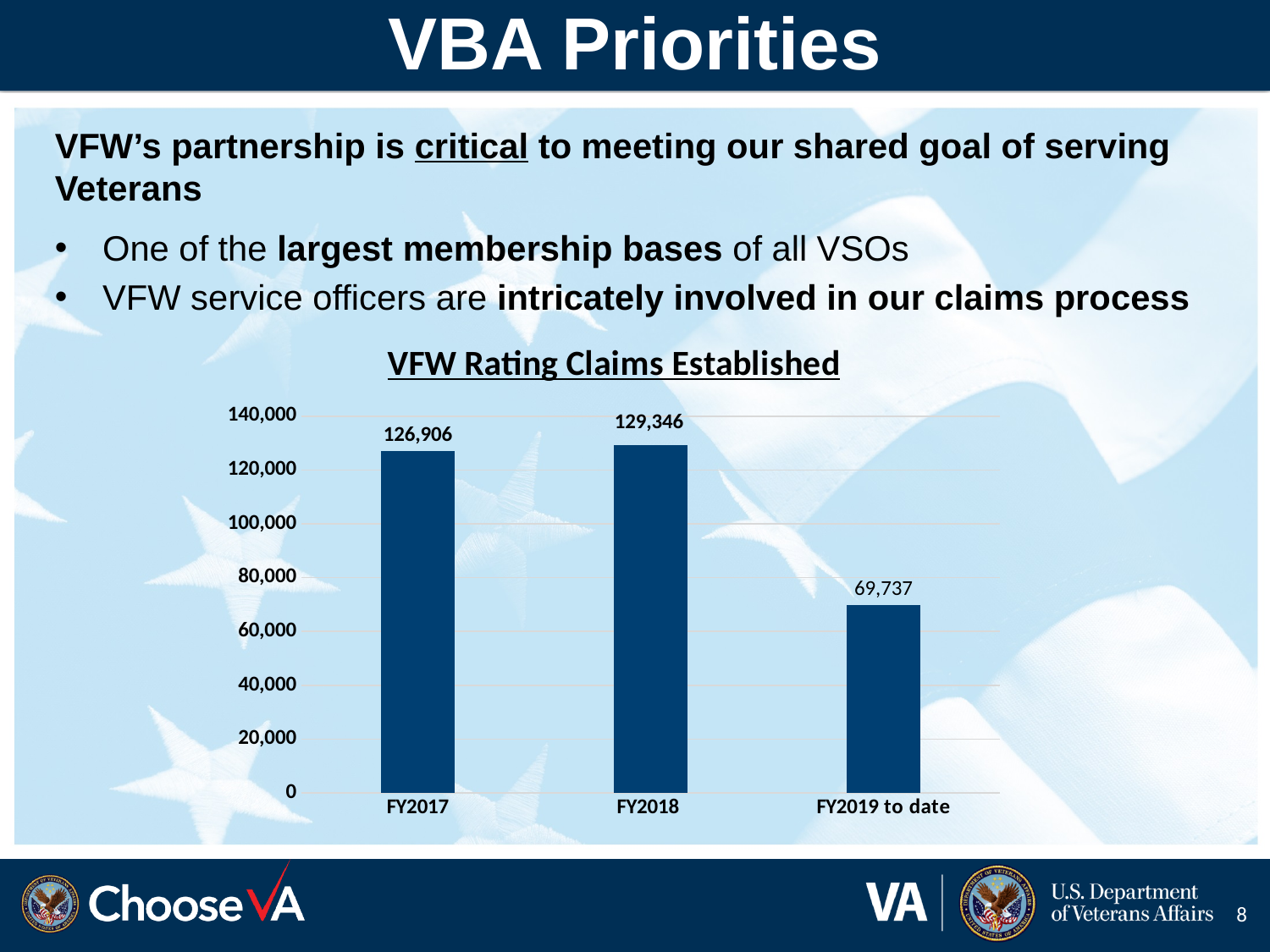
Which is larger in the VFW Rating Claims Established chart, the value for FY2017 or the value for FY2019 to date? FY2017 Which category has the lowest value in the VFW Rating Claims Established chart? FY2019 to date What is the difference between the FY2018 and FY2019 to date values in the VFW Rating Claims Established chart? 59,609 What kind of chart is the VFW Rating Claims Established chart? bar chart What is the value for FY2018 in the VFW Rating Claims Established chart? 129,346 Which category has the highest value in the VFW Rating Claims Established chart? FY2018 What is the title of the chart on the slide? VFW Rating Claims Established How many categories are shown in the VFW Rating Claims Established chart? 3 What is the value for FY2017 in the VFW Rating Claims Established chart? 126,906 What is the difference between the FY2018 and FY2017 values in the VFW Rating Claims Established chart? 2,440 What is the value for FY2019 to date in the VFW Rating Claims Established chart? 69,737 Is the value for FY2019 to date greater or less than 80,000 in the VFW Rating Claims Established chart? less